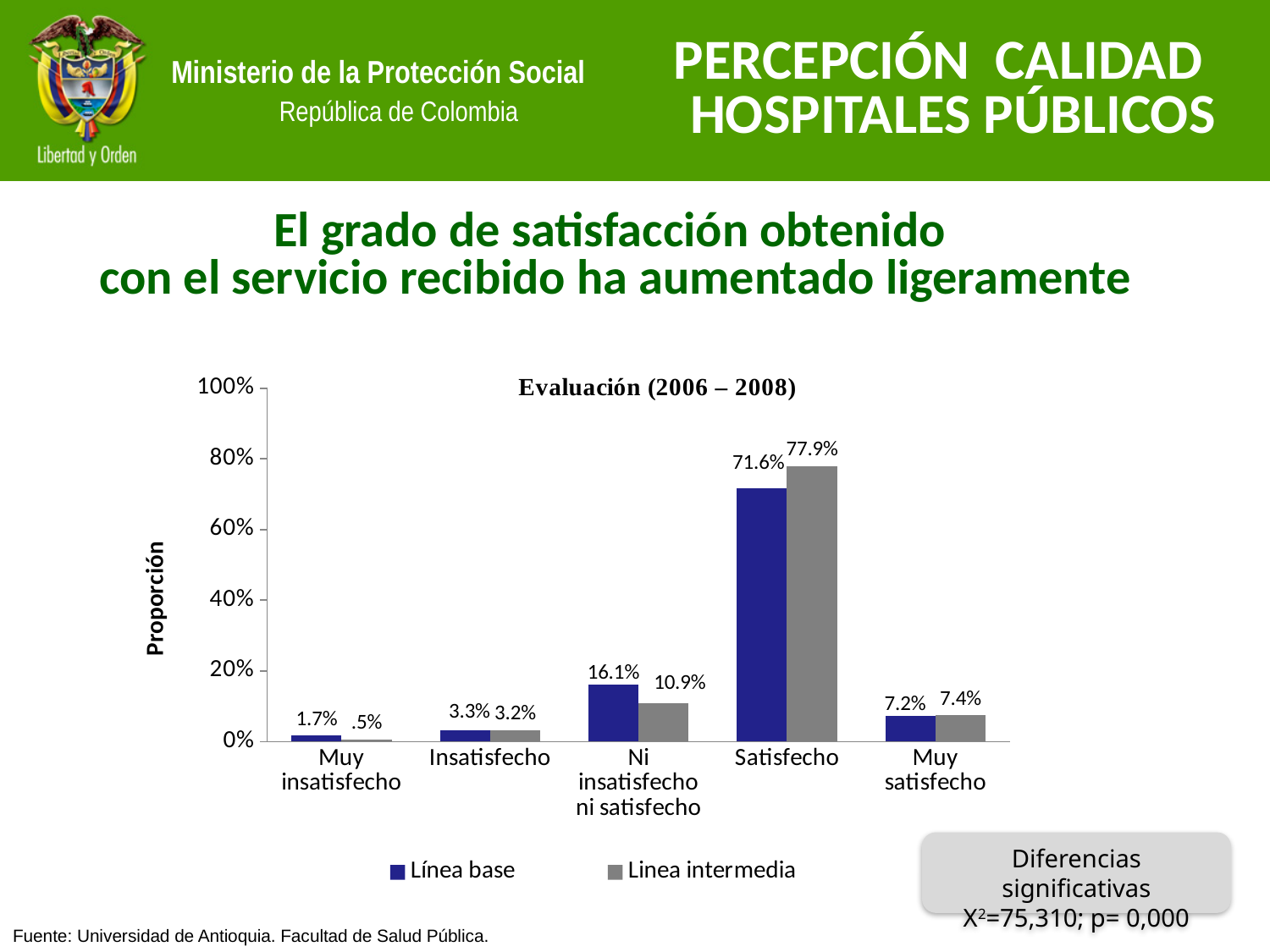
For Ni insatisfecho ni satisfecho, which series has the larger value, Línea base or Linea intermedia? Línea base What kind of chart is shown on the slide? Bar chart What is the value for Satisfecho in the Linea intermedia series? 77.9% What is the difference between the Linea intermedia and Línea base values for Satisfecho? 6.3% How many series does the legend list? 2 Which category has the lowest value in the Línea base series? Muy insatisfecho Which category has the highest value in the Linea intermedia series? Satisfecho What is the value for Muy insatisfecho in the Linea intermedia series? .5% How many categories are shown on the x axis? 5 Is the Línea base value for Satisfecho greater or less than 60%? greater What is the value for Satisfecho in the Línea base series? 71.6% What is the value for Ni insatisfecho ni satisfecho in the Línea base series? 16.1%